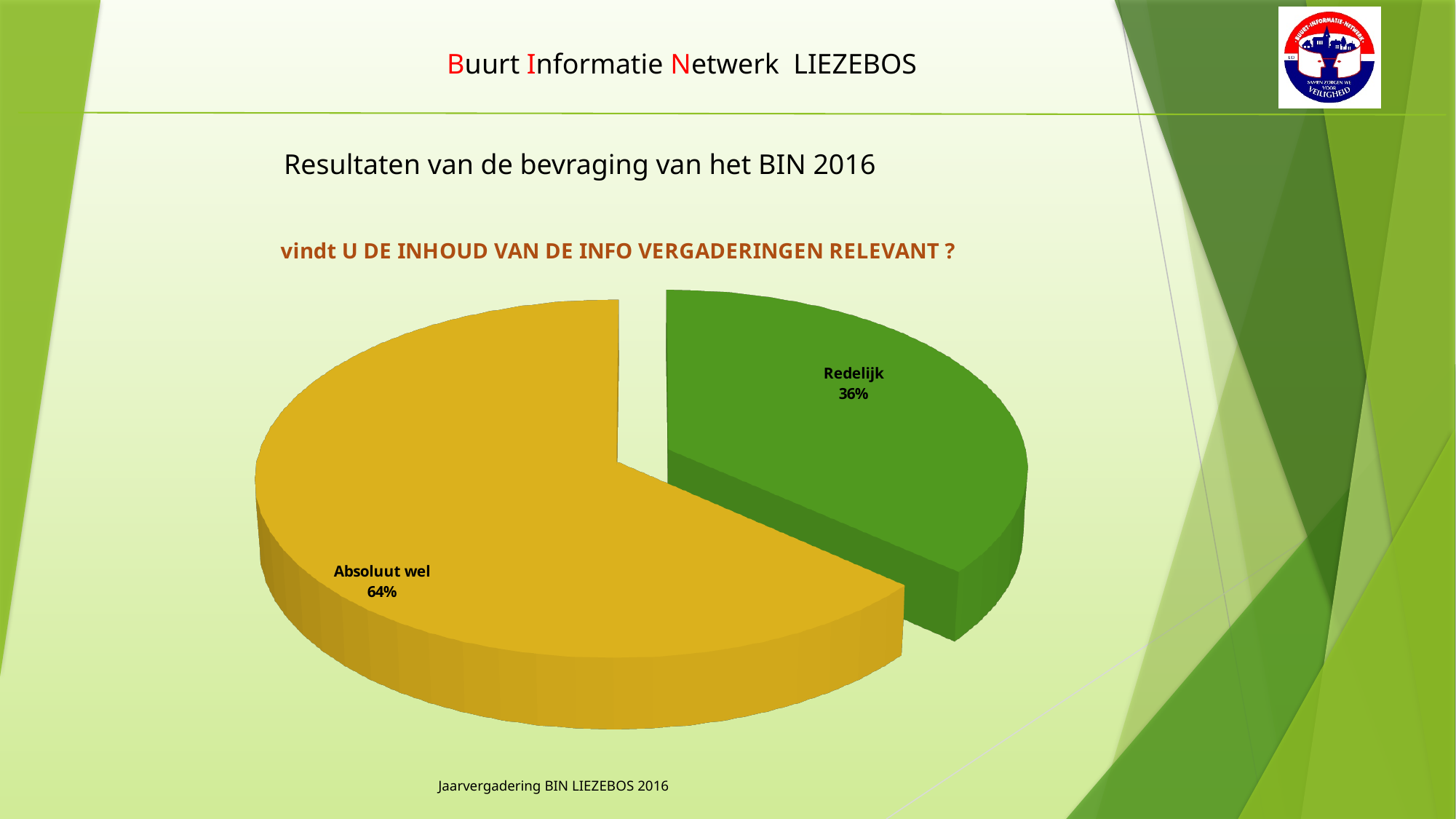
How many slices does the pie chart have? 2 Which category has the largest share of the pie? Absoluut wel Which is larger, the share for "Absoluut wel" or the share for "Redelijk"? Absoluut wel What share of the pie does the "Redelijk" slice represent? 36% What colour is the "Redelijk" slice? Green What is the difference in percentage points between "Absoluut wel" and "Redelijk"? 28 What percentage of respondents answered "Absoluut wel"? 64% Which category has the smallest share of the pie? Redelijk What kind of chart is shown on the slide? Pie chart What is the title of the chart? vindt U DE INHOUD VAN DE INFO VERGADERINGEN RELEVANT ? What percentage of respondents answered "Redelijk"? 36%